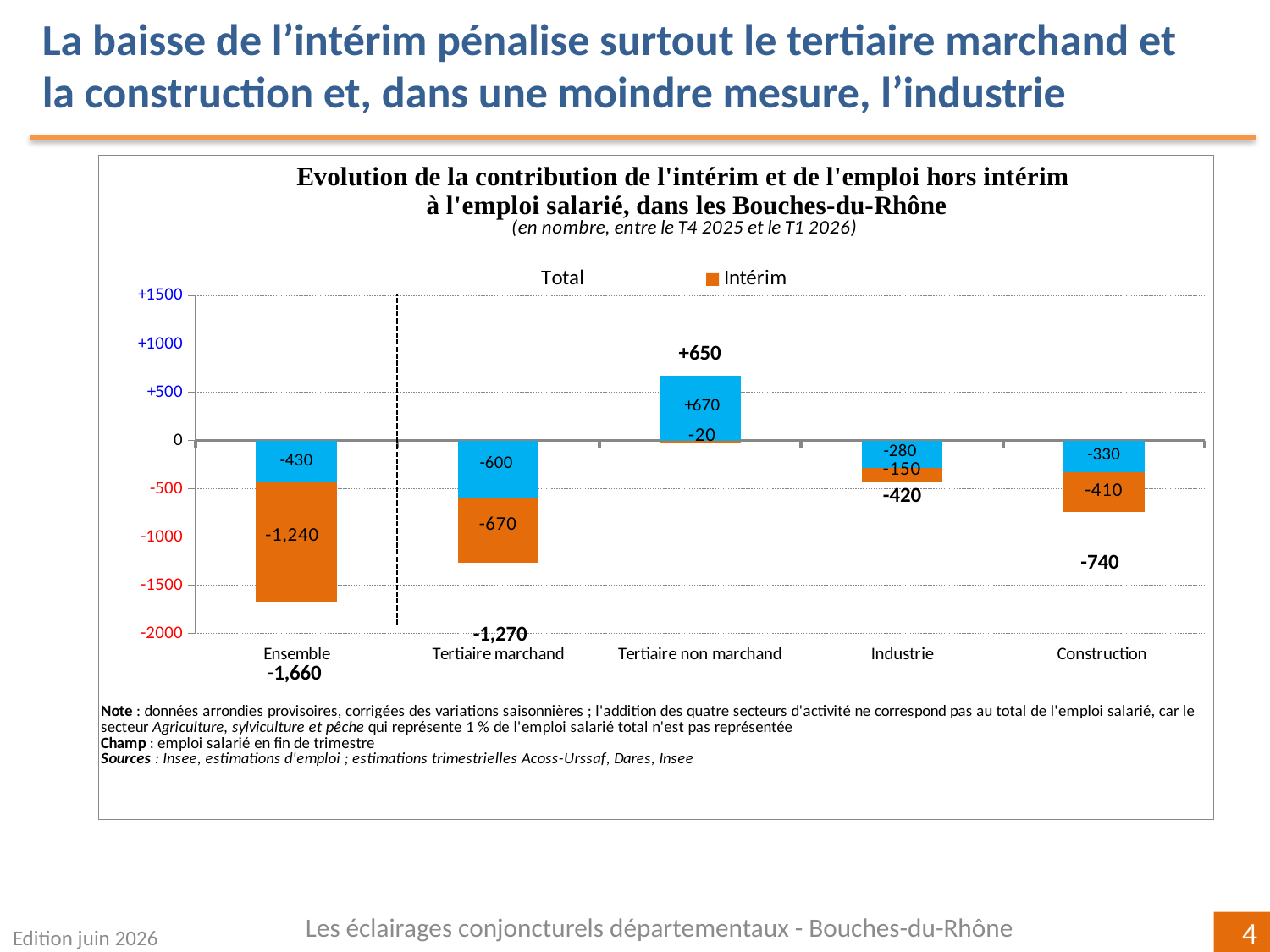
Which sector shows a larger decline in Intérim, Construction or Industrie? Construction What is the total shown for Industrie? -420 What is the total of the stacked bar for Tertiaire marchand? -1,270 What is the Intérim value for Ensemble? -1,240 Which category has the highest total? Tertiaire non marchand How many series does the legend list? 2 What is the difference between the Intérim values for Tertiaire marchand and Industrie? 520 How many categories are shown on the x axis? 5 What kind of chart is this? Bar chart Which category has the lowest total? Ensemble What is the Intérim value for Construction? -410 What is the value of the blue bar for Tertiaire non marchand? +670